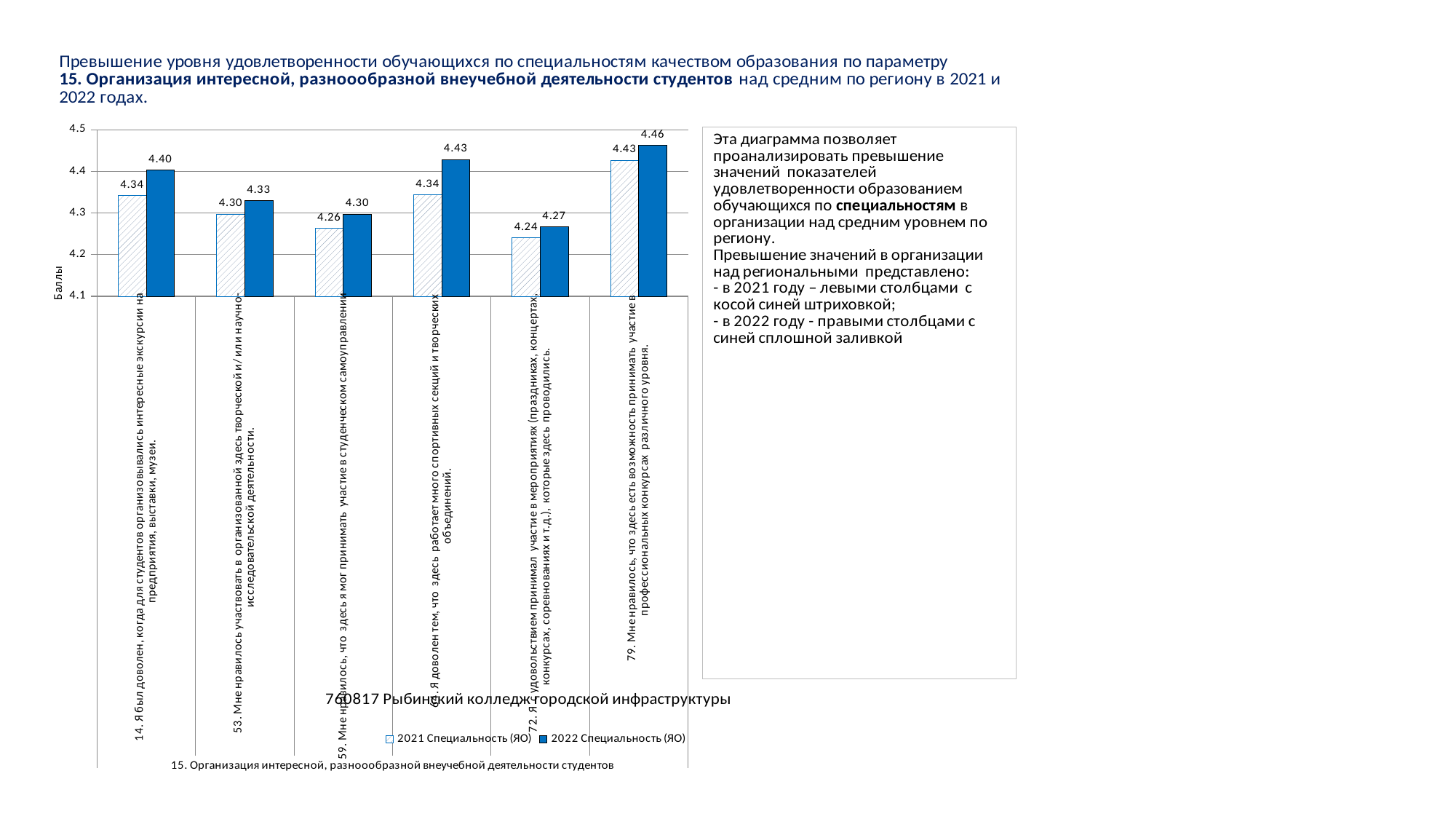
How many series does the chart legend list? 2 What is the label of the vertical axis? Баллы What is the 2021 value for statement 53 (Мне нравилось участвовать в организованной здесь творческой и/или научно-исследовательской деятельности)? 4.30 For statement 59 (Мне нравилось, что здесь я мог принимать участие в студенческом самоуправлении), which is larger: the 2021 value or the 2022 value? 2022 What is the 2022 value for statement 79 (Мне нравилось, что здесь есть возможность принимать участие в профессиональных конкурсах)? 4.46 What is the 2021 value for statement 72 (Я с удовольствием принимал участие в мероприятиях)? 4.24 Which statement has the highest 2022 value? 79. Мне нравилось, что здесь есть возможность принимать участие в профессиональных конкурсах различного уровня. What type of chart is shown on the slide? bar chart What is the 2022 value for statement 14 (Я был доволен, когда для студентов организовывались интересные экскурсии)? 4.40 Which statement has the lowest 2021 value? 72. Я с удовольствием принимал участие в мероприятиях (праздниках, концертах, конкурсах, соревнованиях и т.д.), которые здесь проводились. What is the difference between the 2022 and 2021 values for the statement about sports sections and creative associations (Я доволен тем, что здесь работает много спортивных секций и творческих объединений)? 0.09 How many categories (statements) are plotted on the chart? 6